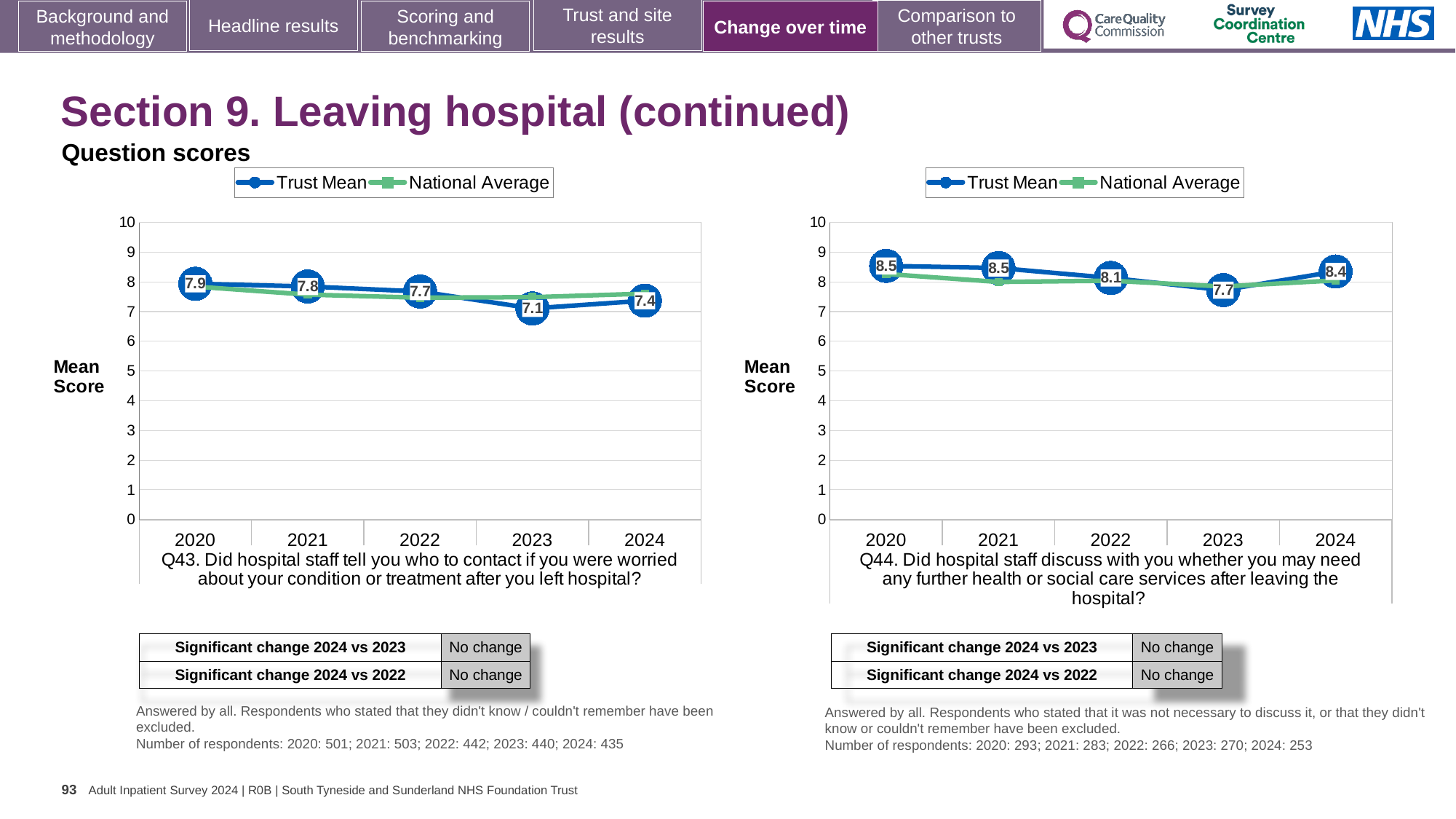
In the Q44 chart on the right, what is the difference between the Trust Mean scores for 2024 and 2023? 0.7 How many years are shown on the x axis of the Q43 chart on the left? 5 In the Q44 chart on the right, is the Trust Mean score higher in 2022 or in 2023? 2022 What type of chart is the Q43 chart on the left? Line chart In the Q43 chart on the left, is the National Average value for 2023 greater or less than 7? greater In the Q44 chart on the right, which year has the lowest Trust Mean score? 2023 In the Q44 chart on the right, what is the Trust Mean score for 2024? 8.4 In the Q43 chart on the left, does the Trust Mean score rise or fall from 2020 to 2023? Fall In the Q43 chart on the left, what is the difference between the Trust Mean scores for 2020 and 2023? 0.8 How many series does the legend of the Q44 chart on the right list? 2 In the Q43 chart on the left, which year has the highest Trust Mean score? 2020 In the Q43 chart on the left, what is the Trust Mean score for 2023? 7.1